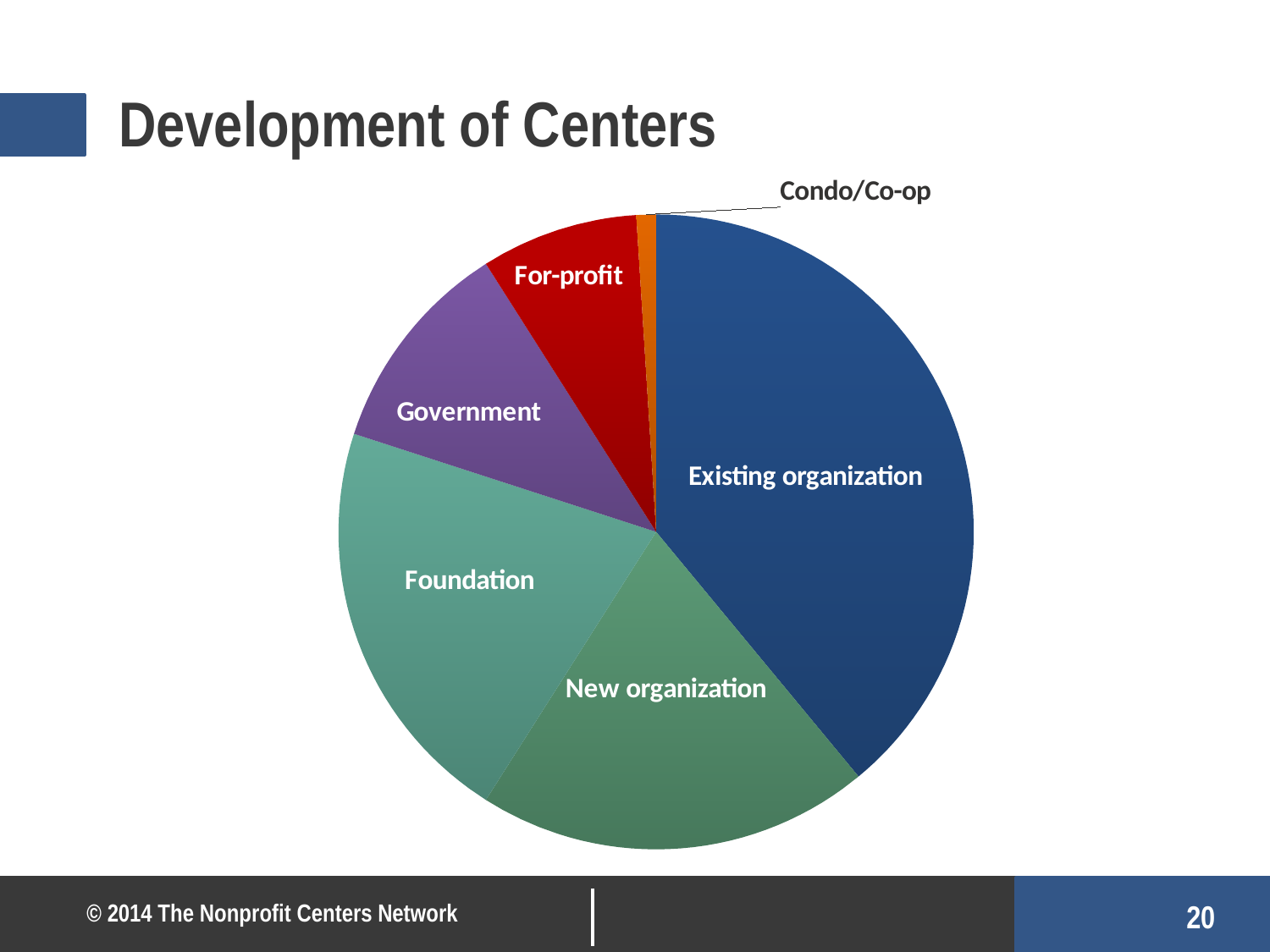
Which category has the largest slice of the pie? Existing organization Which slice is larger, Government or For-profit? Government What is the title of the slide containing the pie chart? Development of Centers Which slice is larger, Existing organization or Government? Existing organization Which slice is larger, Condo/Co-op or For-profit? For-profit What colour is the For-profit slice of the pie chart? Red Which category has the smallest slice of the pie? Condo/Co-op What kind of chart is shown on the slide? Pie chart How many slices does the pie chart have? 6